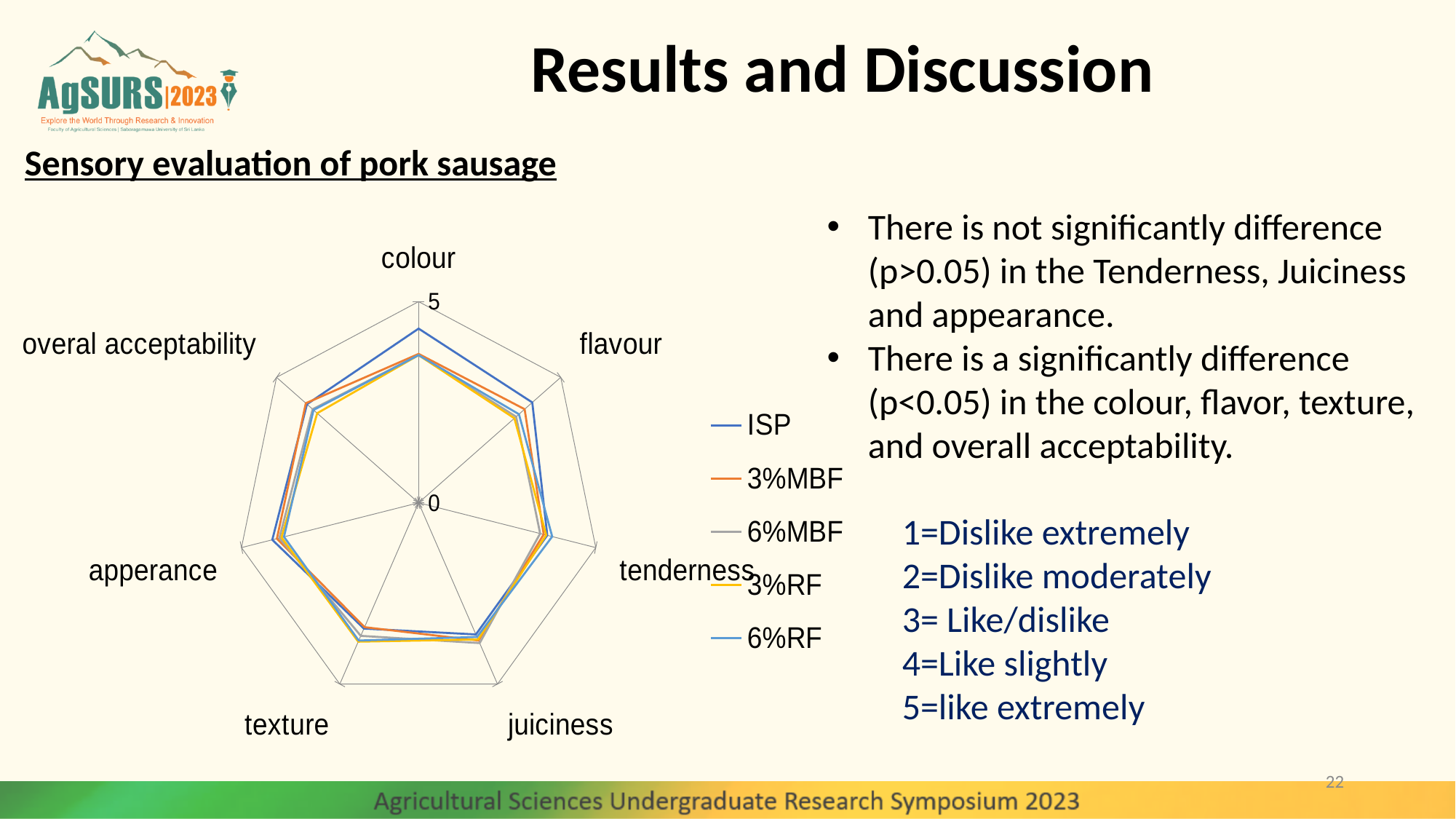
Is the ISP value for colour greater or less than 5? less What kind of chart is shown on the slide? Radar chart How many sensory attributes (categories) are plotted on the radar chart? 7 How many series does the legend of the radar chart list? 5 Which category label appears at the top of the radar chart? colour Which series has the highest value for colour on the radar chart? ISP For colour, which series scores higher: ISP or 3%MBF? ISP What is the maximum value shown on the radar chart's axis? 5 Which series is listed first in the legend of the radar chart? ISP Is the 3%RF value for overal acceptability greater or less than 0? greater